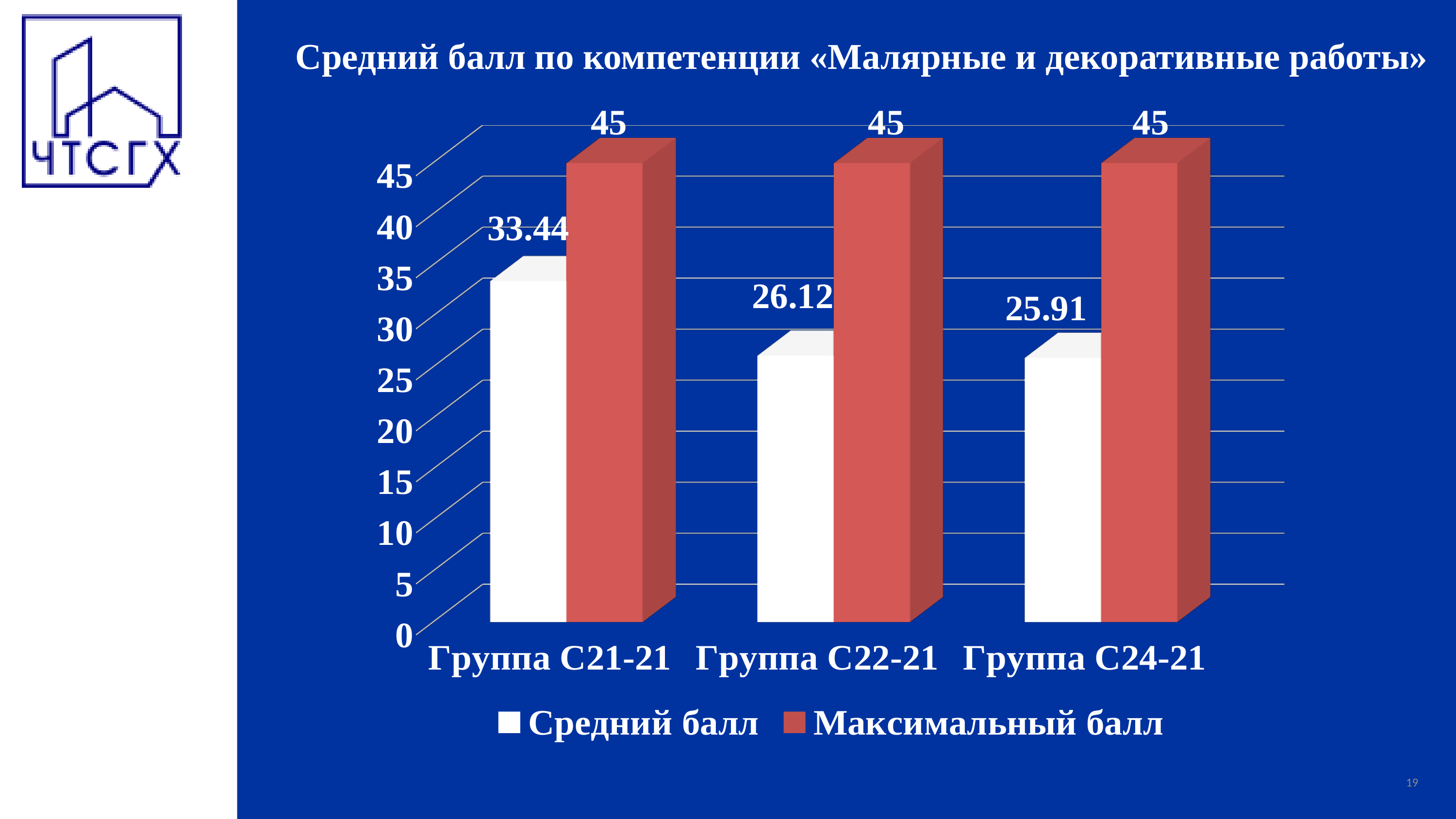
Which group has the highest Средний балл? Группа С21-21 What is the Средний балл for Группа С21-21? 33.44 What is the difference between the Средний балл of Группа С21-21 and Группа С22-21? 7.32 How many series does the legend list? 2 What is the Максимальный балл for Группа С22-21? 45 How many groups are shown on the x axis? 3 Which is larger, the Средний балл for Группа С21-21 or for Группа С24-21? Группа С21-21 What is the difference between the Максимальный балл and the Средний балл for Группа С21-21? 11.56 Is the Средний балл for Группа С22-21 greater or less than 30? less What is the Средний балл for Группа С24-21? 25.91 What is the Средний балл for Группа С22-21? 26.12 What kind of chart is shown on the slide? bar chart